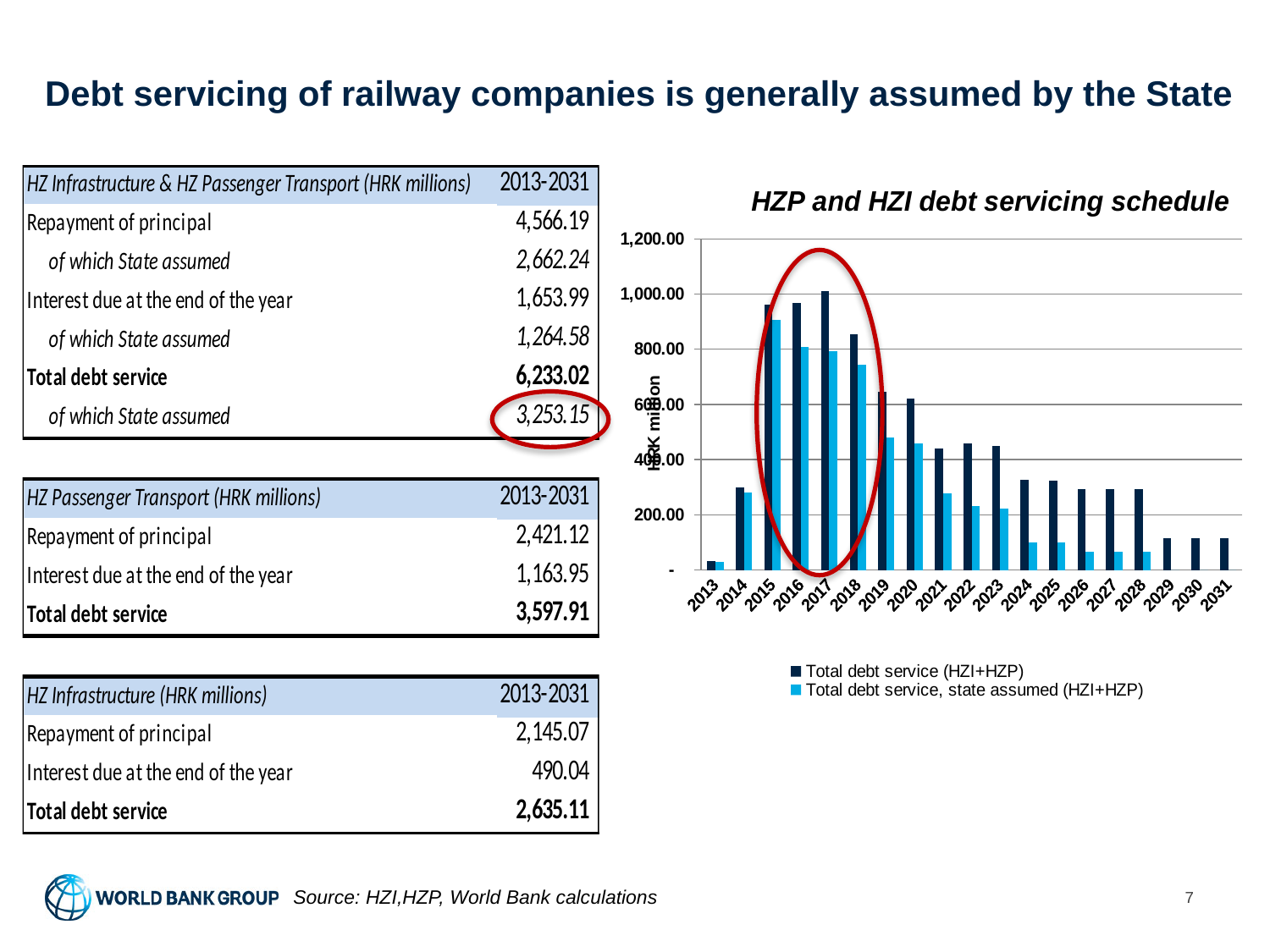
Is the Total debt service, state assumed (HZI+HZP) value for 2015 greater or less than 800.00? greater What kind of chart is shown on the slide? bar chart Is the Total debt service (HZI+HZP) value for 2017 greater or less than 800.00? greater Which year has the lowest Total debt service (HZI+HZP) in the chart? 2013 Is the Total debt service (HZI+HZP) value for 2013 greater or less than 200.00? less What are the two series named in the chart legend? Total debt service (HZI+HZP); Total debt service, state assumed (HZI+HZP) What is the title of the chart? HZP and HZI debt servicing schedule How many series does the chart legend list? 2 Which year has the larger Total debt service (HZI+HZP): 2015 or 2025? 2015 Which year has the highest Total debt service (HZI+HZP) in the chart? 2017 How many years are shown along the x axis of the chart? 19